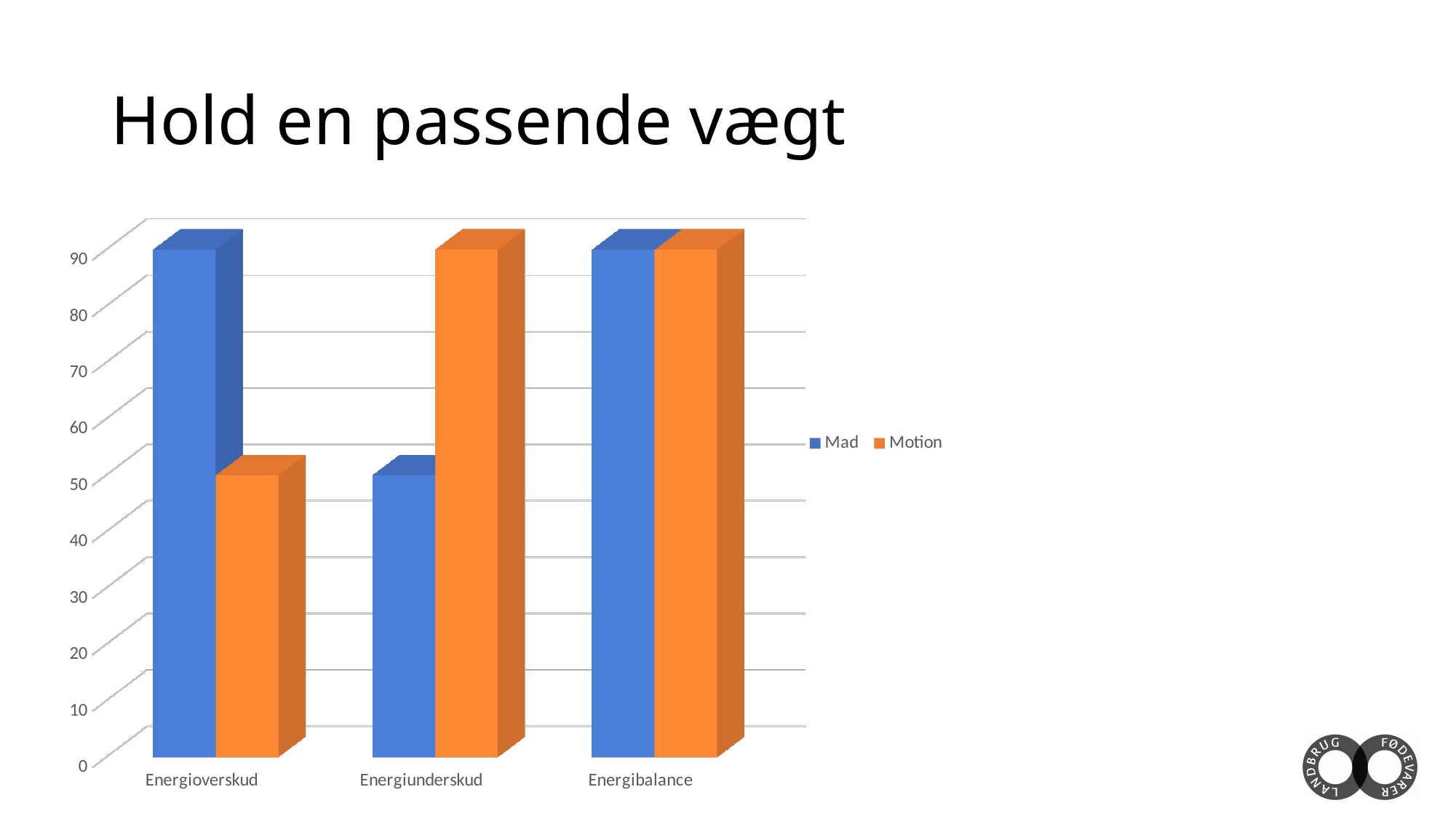
Is the value for Motion in the Energioverskud category greater or less than 60? less In the Energioverskud category, which series has the larger value, Mad or Motion? Mad How many series does the chart's legend list? 2 In the Energiunderskud category, which series has the larger value, Mad or Motion? Motion What are the two series named in the chart's legend? Mad and Motion How many categories are shown on the x axis of the chart? 3 In which category is the Motion value the lowest? Energioverskud Is the value for Motion in the Energiunderskud category greater or less than 80? greater Which colour represents the Motion series in the chart? orange What kind of chart is shown on the slide? bar chart Is the value for Mad in the Energiunderskud category greater or less than 60? less